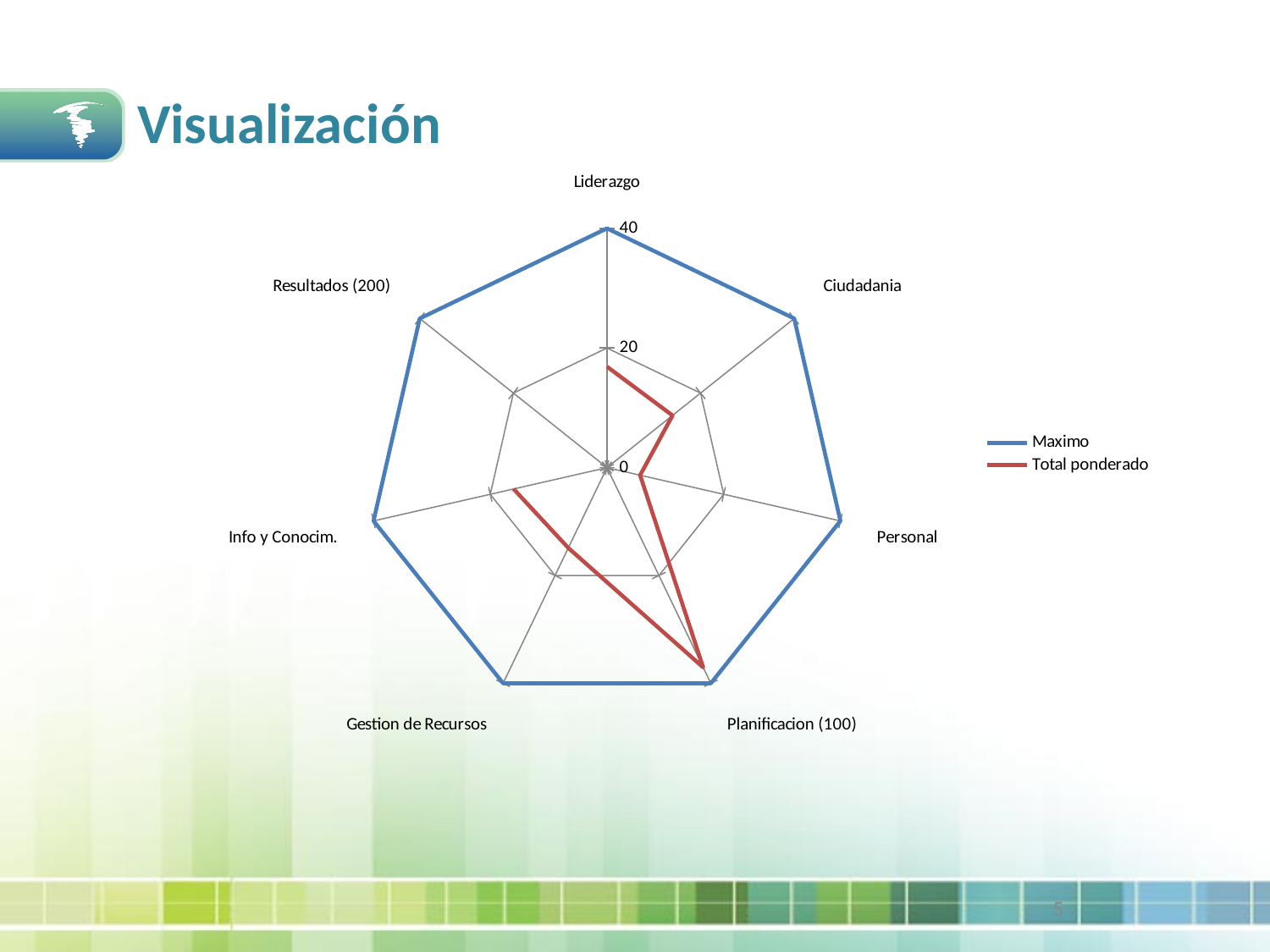
Which has the larger Total ponderado value, Planificacion (100) or Personal? Planificacion (100) What are the two series named in the legend? Maximo and Total ponderado Is the Total ponderado value for Ciudadania greater or less than 20? less Is the Total ponderado value for Personal greater or less than 20? less What kind of chart is shown on the slide? radar chart For which category is the Total ponderado value highest? Planificacion (100) How many series does the legend list? 2 Is the Total ponderado value for Planificacion (100) greater or less than 20? greater How many categories (axes) does the radar chart have? 7 What is the Maximo value for Liderazgo? 40 Which colour is used for the Maximo series? blue